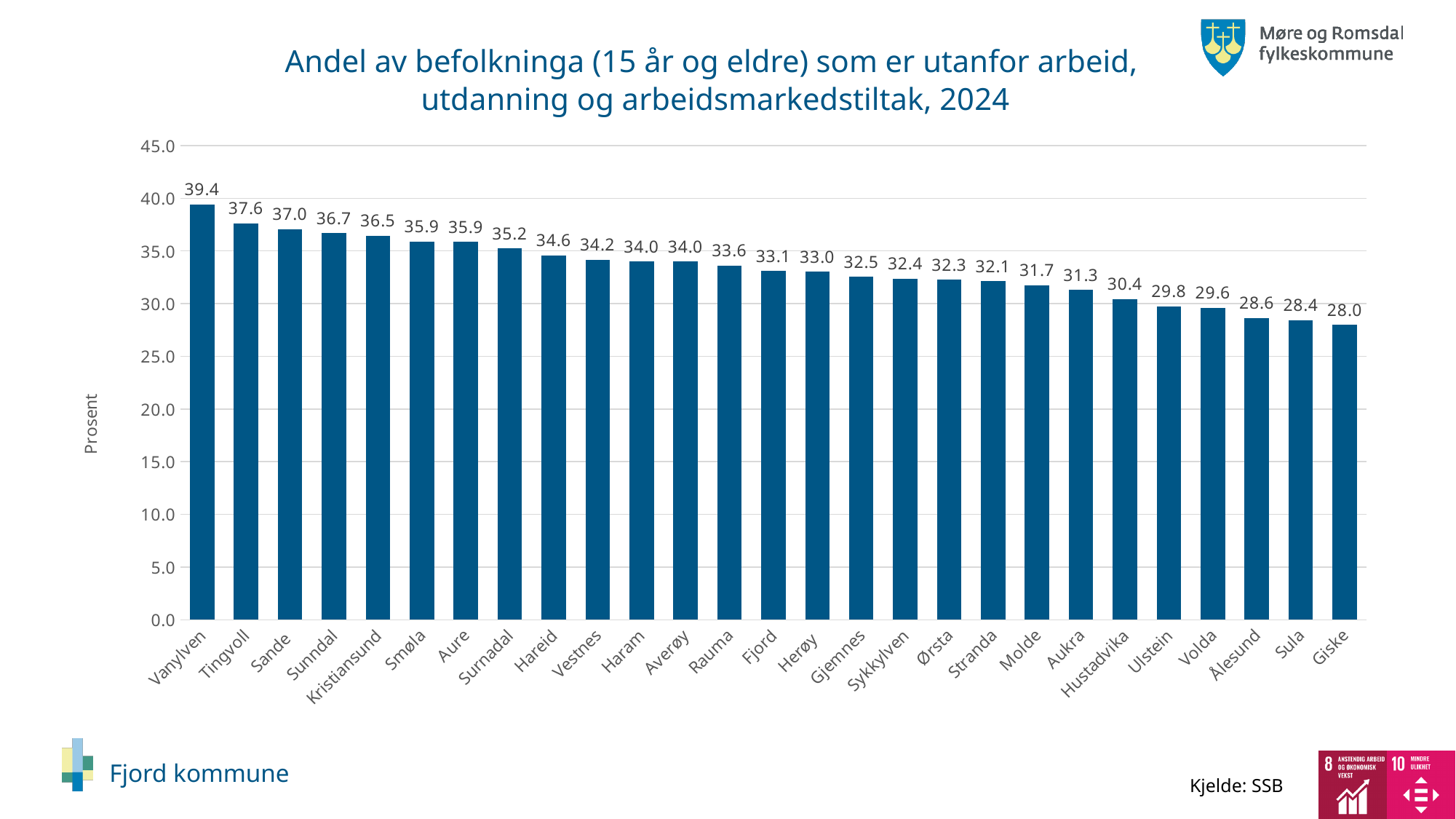
Which municipality has the highest value? Vanylven What is the value for Molde? 31.7 Which has a larger value, Sunndal or Volda? Sunndal What is the difference between the values for Vanylven and Giske? 11.4 Is the value for Hustadvika greater or less than 35.0? less What is the difference between the values for Tingvoll and Ålesund? 9.0 What is the value for Kristiansund? 36.5 Which municipality has the lowest value? Giske What is the label on the vertical axis? Prosent How many municipalities are shown on the chart? 27 What kind of chart is this? bar chart What is the value for Fjord? 33.1